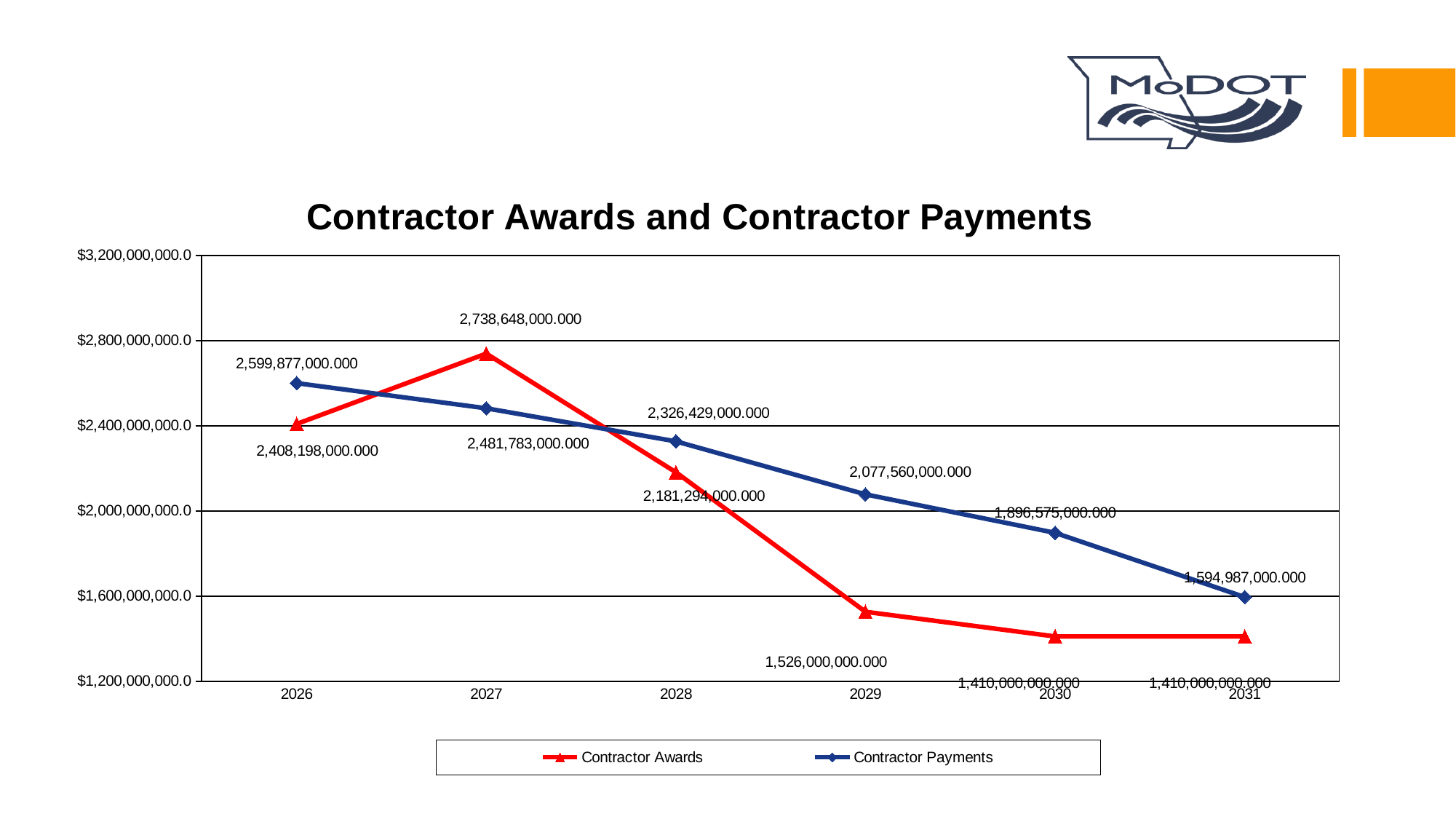
In which year is Contractor Payments lowest? 2031 What is the Contractor Payments value for 2031? 1,594,987,000.000 What is the difference between Contractor Payments and Contractor Awards in 2026? 191,679,000.000 How many years are shown on the x axis? 6 Is the Contractor Payments value for 2028 greater or less than $2,000,000,000.0? greater What is the Contractor Awards value for 2027? 2,738,648,000.000 What kind of chart is shown on the slide? Line chart What is the Contractor Payments value for 2029? 2,077,560,000.000 What is the difference between Contractor Awards and Contractor Payments in 2027? 256,865,000.000 Which is larger in 2029, Contractor Awards or Contractor Payments? Contractor Payments In which year is Contractor Awards highest? 2027 How many series does the legend list? 2